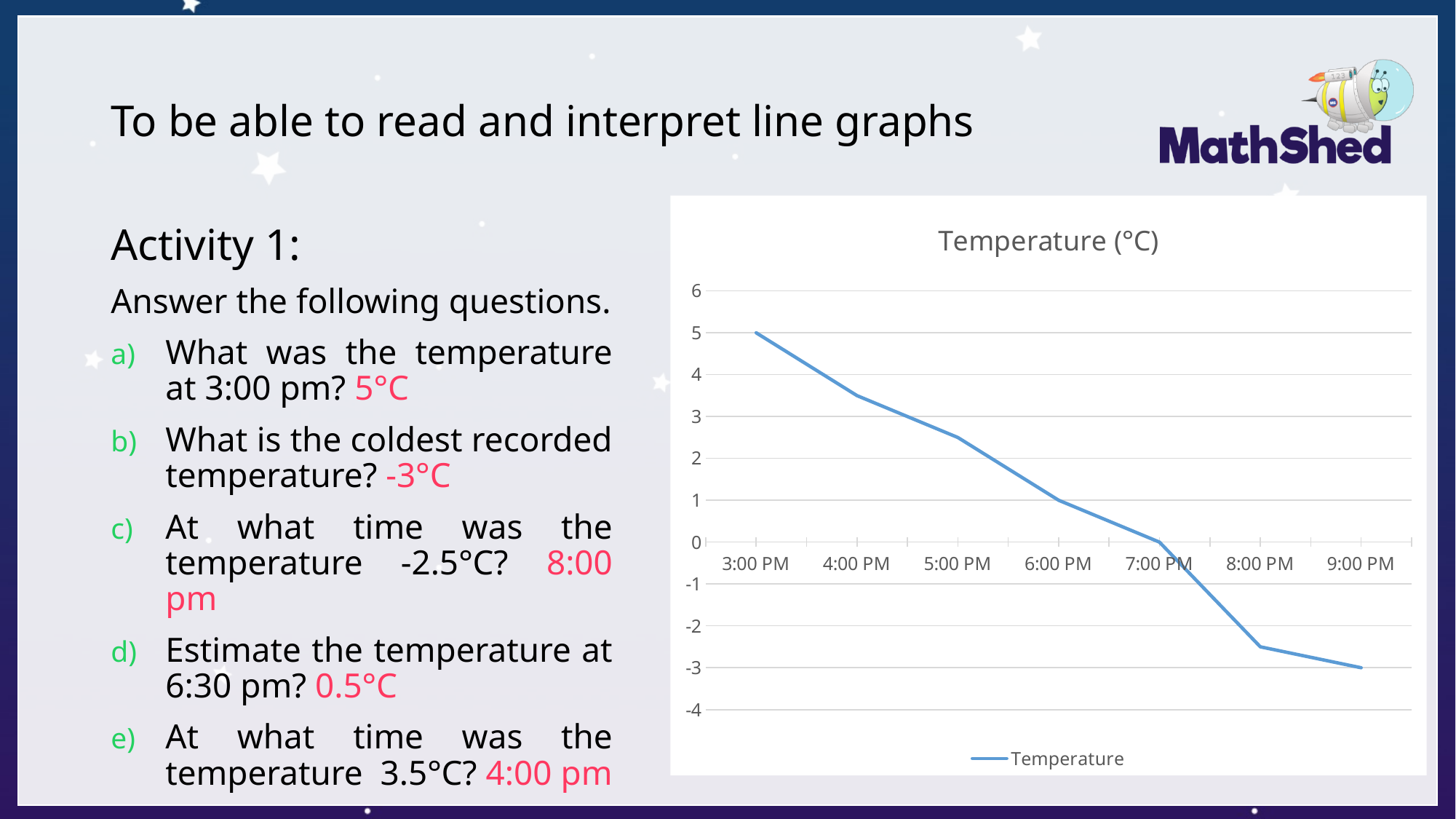
Which is higher, the temperature at 6:00 PM or at 8:00 PM? 6:00 PM Is the temperature at 5:00 PM greater or less than 3? less What was the temperature at 7:00 PM? 0 How many time points are plotted on the chart? 7 What was the temperature at 9:00 PM? -3 Does the temperature rise or fall from 3:00 PM to 9:00 PM? fall At which time was the temperature highest? 3:00 PM How many series does the chart legend list? 1 What is the title of the chart? Temperature (°C) What type of chart is shown on the slide? line chart At which time was the temperature lowest? 9:00 PM What was the temperature at 3:00 PM? 5